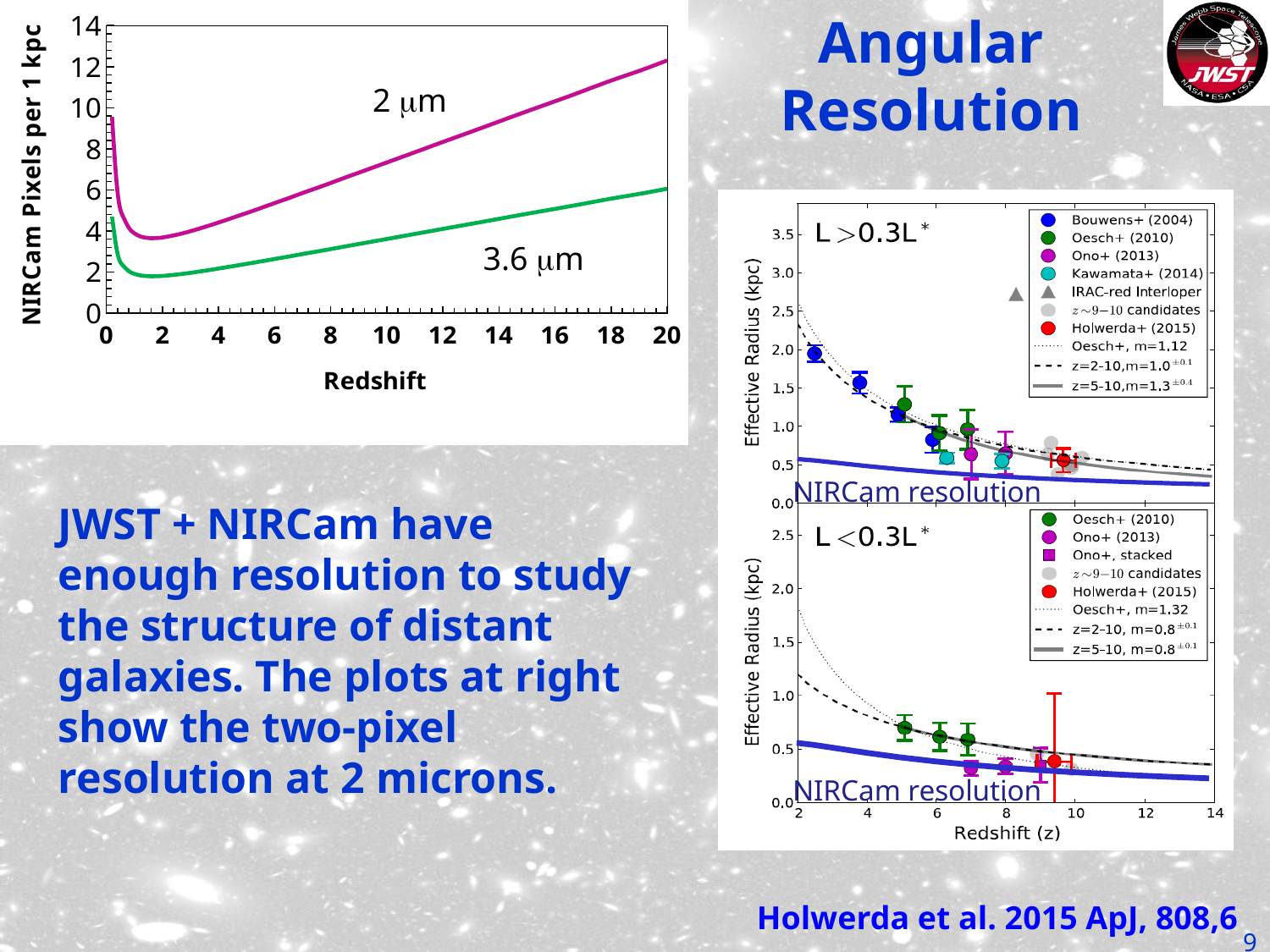
In the top-left chart, which line is higher at redshift 10, 2 μm or 3.6 μm? 2 μm In the top-left chart, is the value of the 2 μm line at redshift 10 greater or less than 6? greater In the right-hand chart labelled L < 0.3L*, how many entries does the legend list? 8 In the right-hand chart labelled L > 0.3L*, how many entries does the legend list? 10 What kind of chart is the top-left chart of NIRCam Pixels per 1 kpc versus Redshift? line chart In the top-left chart, do the lines rise or fall as redshift increases from 4 to 20? rise In the top-left chart, is the value of the 3.6 μm line at redshift 10 greater or less than 2? greater In the right-hand charts, what is the label of the thick blue line? NIRCam resolution What is the label of the x axis of the top-left chart? Redshift In the top-left chart, how many lines (series) are plotted? 2 In the top-left chart, is the value of the 2 μm line at redshift 20 greater or less than 10? greater In the right-hand chart labelled L > 0.3L*, does the effective radius of the plotted points rise or fall as redshift increases? fall